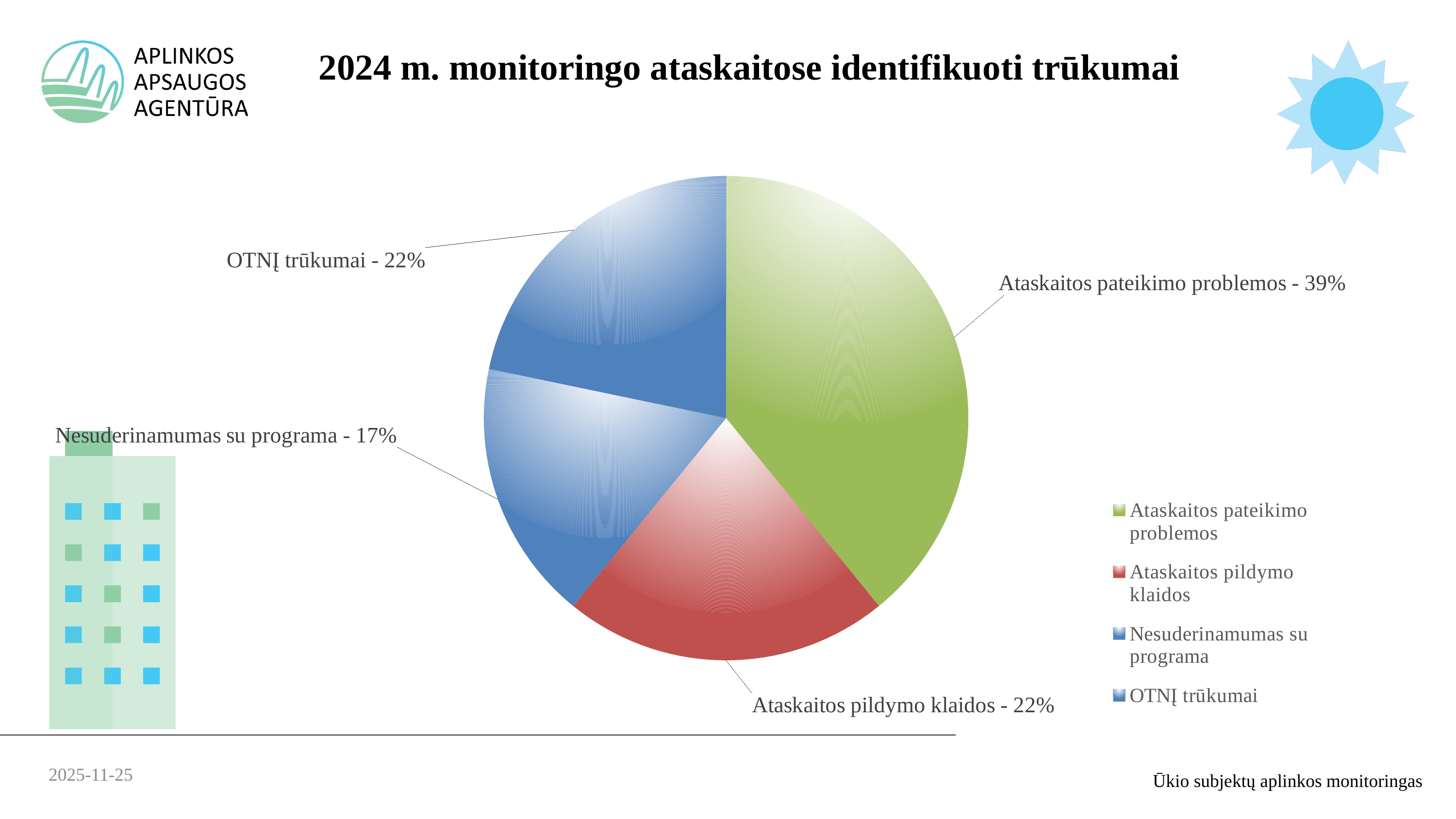
What share of the pie does "Ataskaitos pildymo klaidos" represent? 22% Which category has the largest slice of the pie? Ataskaitos pateikimo problemos Which is larger: the share for "Ataskaitos pildymo klaidos" or the share for "Nesuderinamumas su programa"? Ataskaitos pildymo klaidos What kind of chart is shown on the slide? Pie chart What share of the pie does "OTNĮ trūkumai" represent? 22% Which category has the smallest slice of the pie? Nesuderinamumas su programa What is the title of the chart on the slide? 2024 m. monitoringo ataskaitose identifikuoti trūkumai What is the difference in percentage points between "Ataskaitos pateikimo problemos" and "Nesuderinamumas su programa"? 22 How many categories are shown in the pie chart? 4 What share of the pie does "Ataskaitos pateikimo problemos" represent? 39% What is the difference in percentage points between "OTNĮ trūkumai" and "Nesuderinamumas su programa"? 5